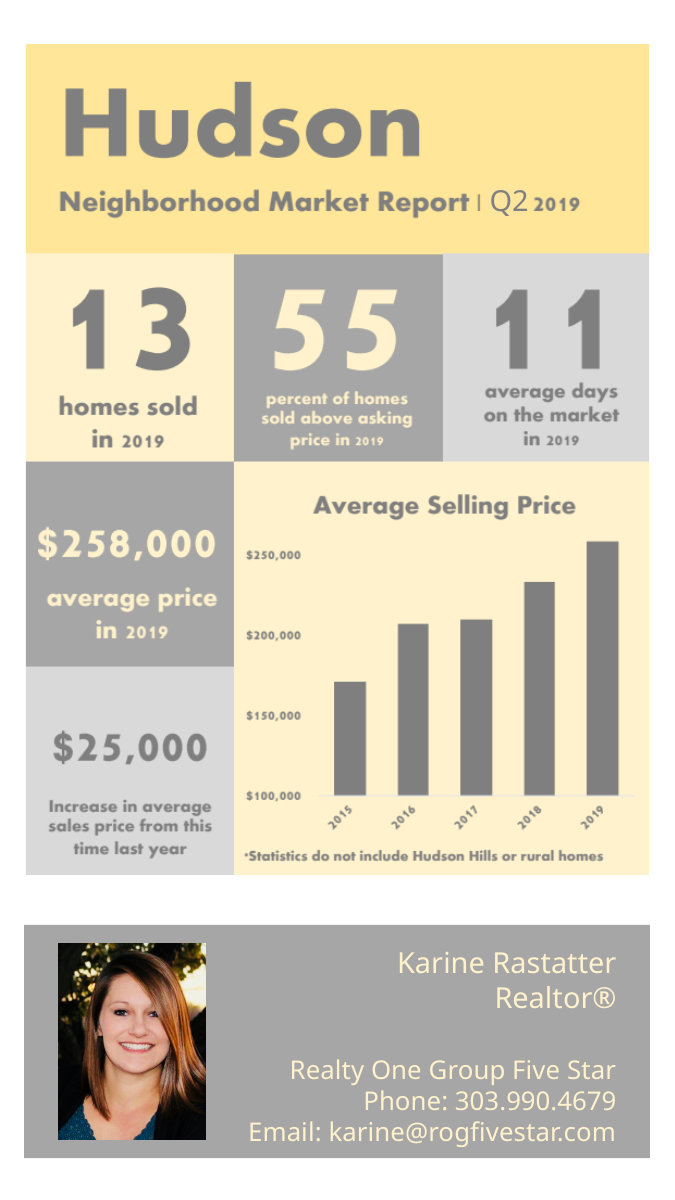
Is the average selling price for 2015 greater or less than $200,000? less Which year has the lowest average selling price on the chart? 2015 Which year has the highest average selling price on the chart? 2019 What is the title of the chart on the slide? Average Selling Price What kind of chart is shown under the title "Average Selling Price"? bar chart Is the average selling price for 2019 greater or less than $250,000? greater What is the lowest value shown on the y axis of the Average Selling Price chart? $100,000 Do the average selling prices rise or fall from 2015 to 2019 on the chart? rise Is the average selling price for 2016 greater or less than $150,000? greater Which year has the higher average selling price on the chart, 2015 or 2018? 2018 How many years are plotted on the Average Selling Price chart? 5